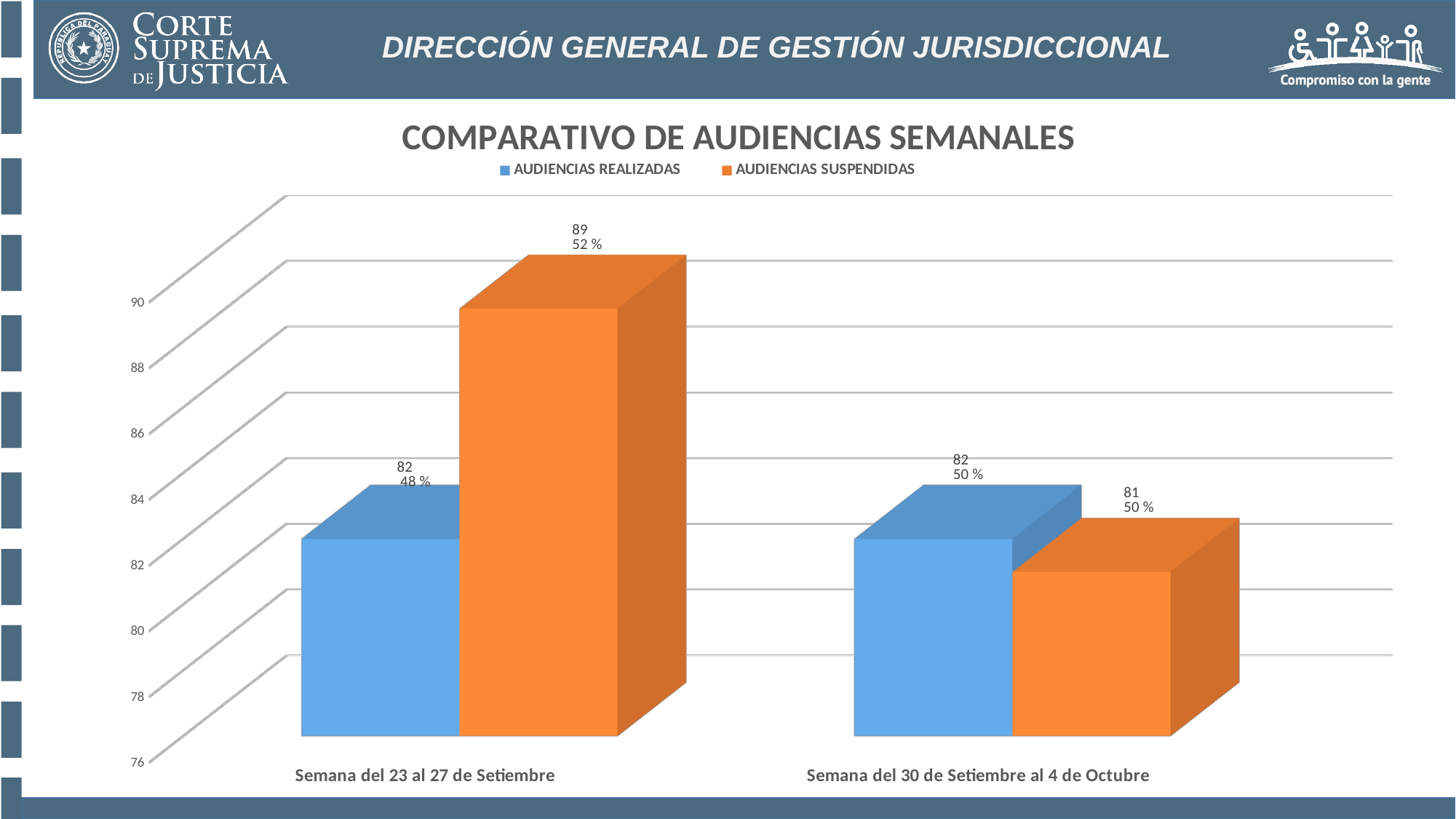
What kind of chart is shown on the slide? Bar chart Which colour represents AUDIENCIAS SUSPENDIDAS in the legend? Orange What is the value of AUDIENCIAS SUSPENDIDAS for Semana del 23 al 27 de Setiembre? 89 What is the value of AUDIENCIAS REALIZADAS for Semana del 30 de Setiembre al 4 de Octubre? 82 Which bar has the highest value in the chart? AUDIENCIAS SUSPENDIDAS, Semana del 23 al 27 de Setiembre What is the value of AUDIENCIAS SUSPENDIDAS for Semana del 30 de Setiembre al 4 de Octubre? 81 What percentage is shown for AUDIENCIAS REALIZADAS in Semana del 23 al 27 de Setiembre? 48 % What is the difference between AUDIENCIAS SUSPENDIDAS and AUDIENCIAS REALIZADAS in Semana del 23 al 27 de Setiembre? 7 How many categories (weeks) are shown on the x axis? 2 In Semana del 30 de Setiembre al 4 de Octubre, which is larger: AUDIENCIAS REALIZADAS or AUDIENCIAS SUSPENDIDAS? AUDIENCIAS REALIZADAS How many series does the legend list? 2 What is the title of the chart? COMPARATIVO DE AUDIENCIAS SEMANALES